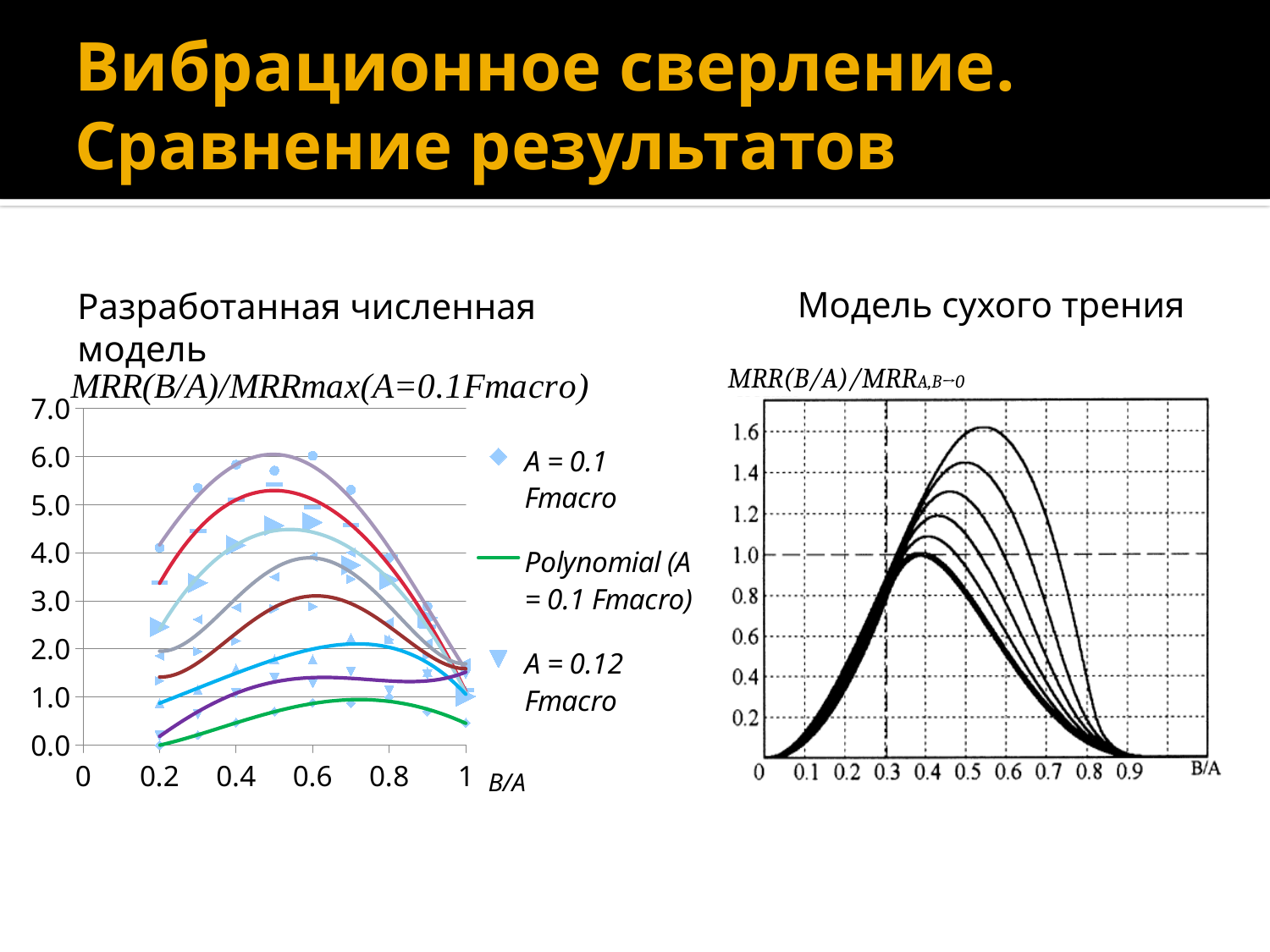
In the right chart (Модель сухого трения), at B/A = 0.1, are the curve values greater or less than 0.2? less In the right chart (Модель сухого трения), how many curves are plotted? 6 In the left chart, what is the highest value shown on the y axis? 7.0 In the left chart, what is the label of the x axis? B/A In the right chart (Модель сухого трения), what is the highest tick value shown on the y axis? 1.6 In the left chart, what kind of chart is it? Scatter chart with trendlines What is the title of the chart on the right side of the slide? Модель сухого трения In the left chart, does the red curve rise or fall between B/A = 0.6 and B/A = 1? Fall In the left chart, is the peak of the topmost curve (around B/A = 0.5) greater or less than 5.0? greater What is the title printed above the left chart? MRR(B/A)/MRRmax(A=0.1Fmacro) In the right chart (Модель сухого трения), how do the curves behave as B/A increases from 0 to 0.9? They rise to a peak and then fall back toward zero In the right chart (Модель сухого трения), is the peak of the highest curve greater or less than 1.4? greater